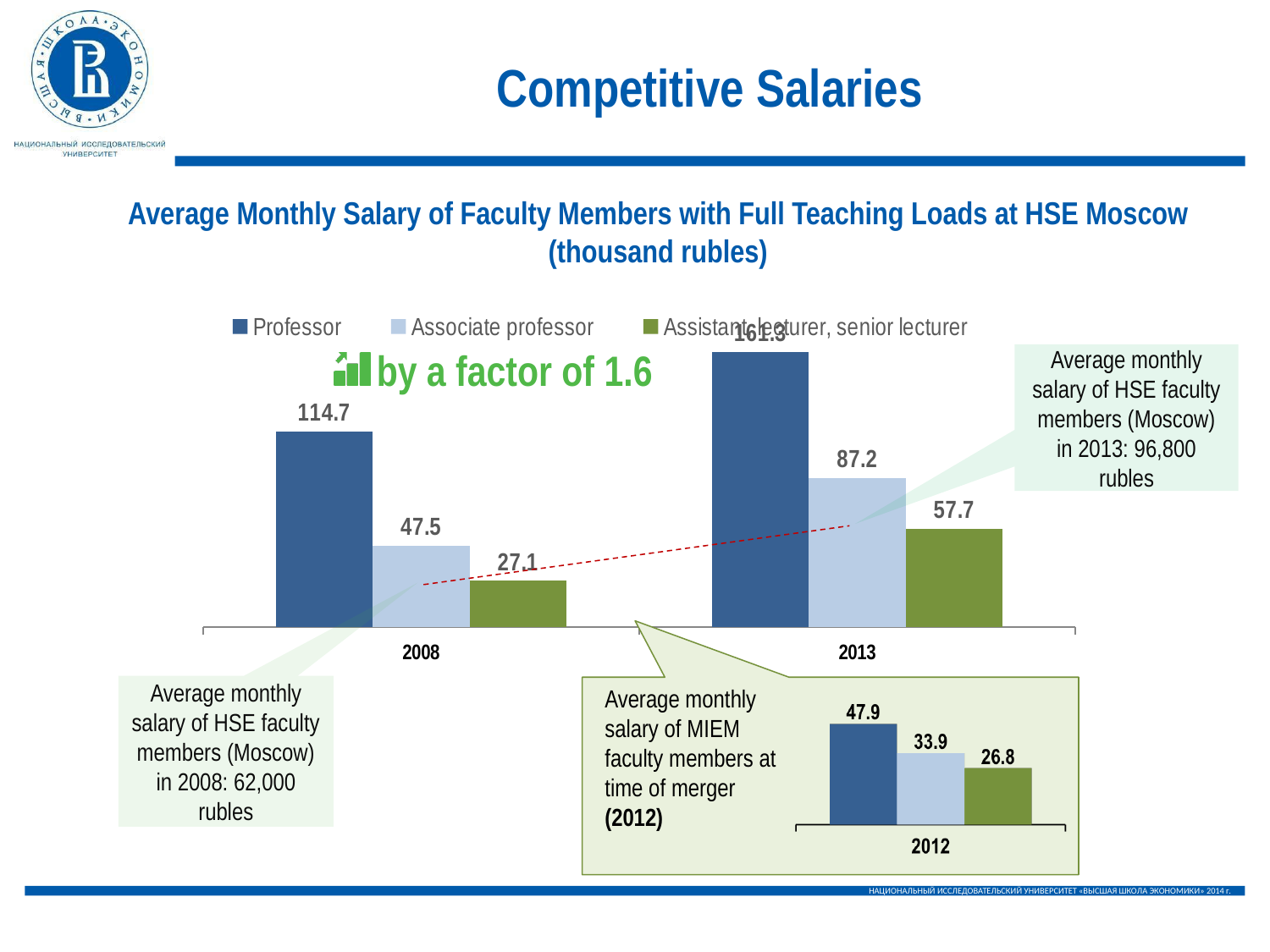
In the main chart, what is the difference between the Associate professor values in 2013 and 2008? 39.7 In the main chart, which series has the highest value in 2013? Professor In the main chart, what is the value for Associate professor in 2013? 87.2 In the inset chart for 2012 (MIEM faculty members), what is the value for Professor? 47.9 In the main chart, is the Associate professor value in 2008 larger or smaller than the Assistant lecturer, senior lecturer value in 2013? smaller How many series does the legend of the main chart list? 3 In the main chart, which series has the lowest value in 2008? Assistant lecturer, senior lecturer In the main chart, what is the average monthly salary of a Professor in 2008? 114.7 What kind of chart is the main chart on the slide? bar chart In the main chart, what is the value for Assistant lecturer, senior lecturer in 2008? 27.1 In the main chart, what is the value for Assistant lecturer, senior lecturer in 2013? 57.7 In the inset chart for 2012 (MIEM faculty members), what is the difference between the Associate professor and Assistant lecturer, senior lecturer values? 7.1